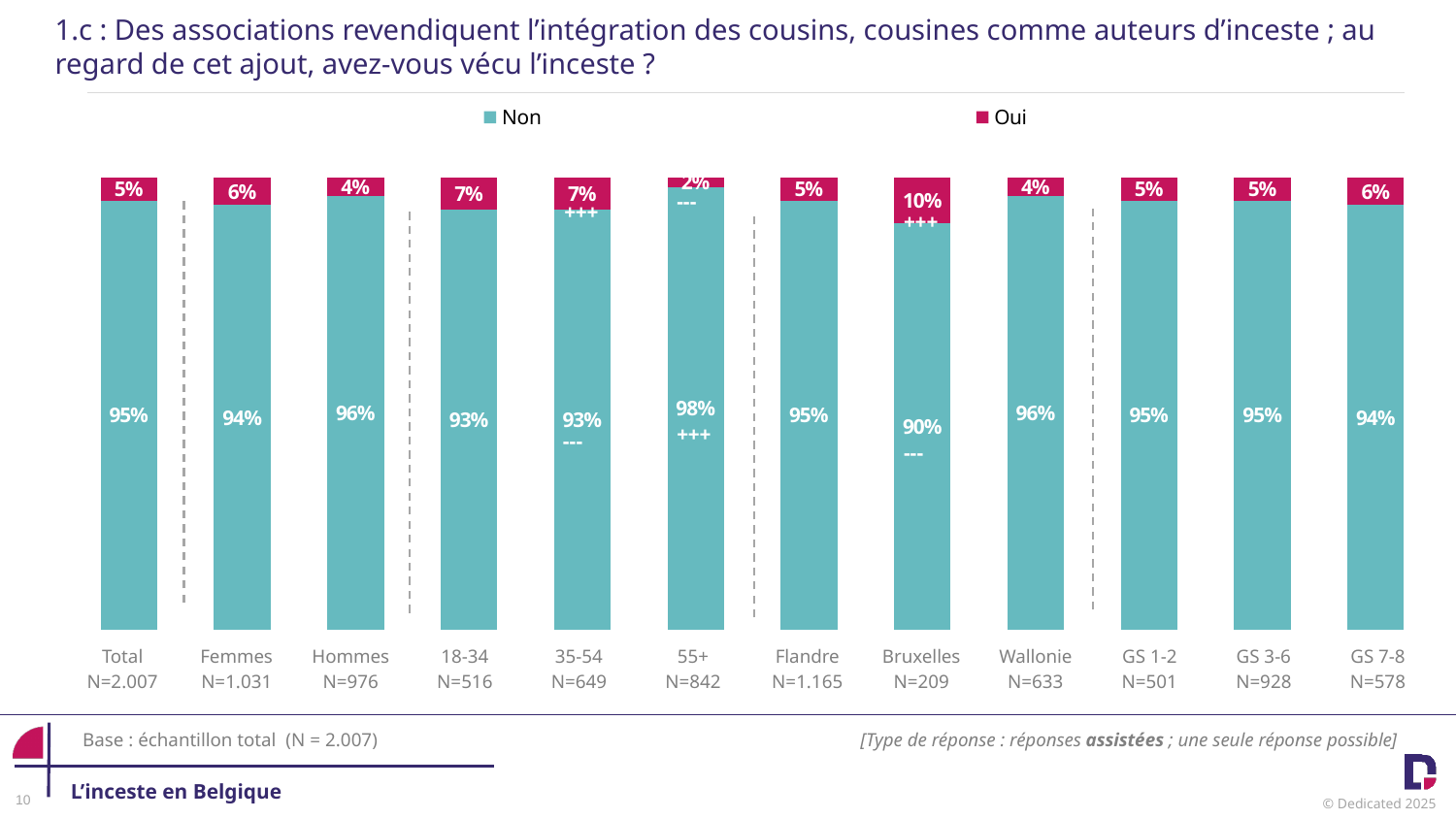
What is the 'Non' value for Hommes? 96% How many series does the legend list? 2 What is the 'Oui' value for the 55+ age group? 2% Which category has the highest 'Non' value? 55+ What is the difference between the 'Oui' values for Bruxelles and Wallonie? 6 percentage points Which category has the highest 'Oui' value? Bruxelles What is the 'Oui' value for Bruxelles? 10% Which category has the lowest 'Non' value? Bruxelles What is the total of the stacked bar for Flandre? 100% How many categories are shown on the x axis? 12 Which is larger, the 'Oui' value for Femmes or for Hommes? Femmes What kind of chart is shown on the slide? Stacked bar chart